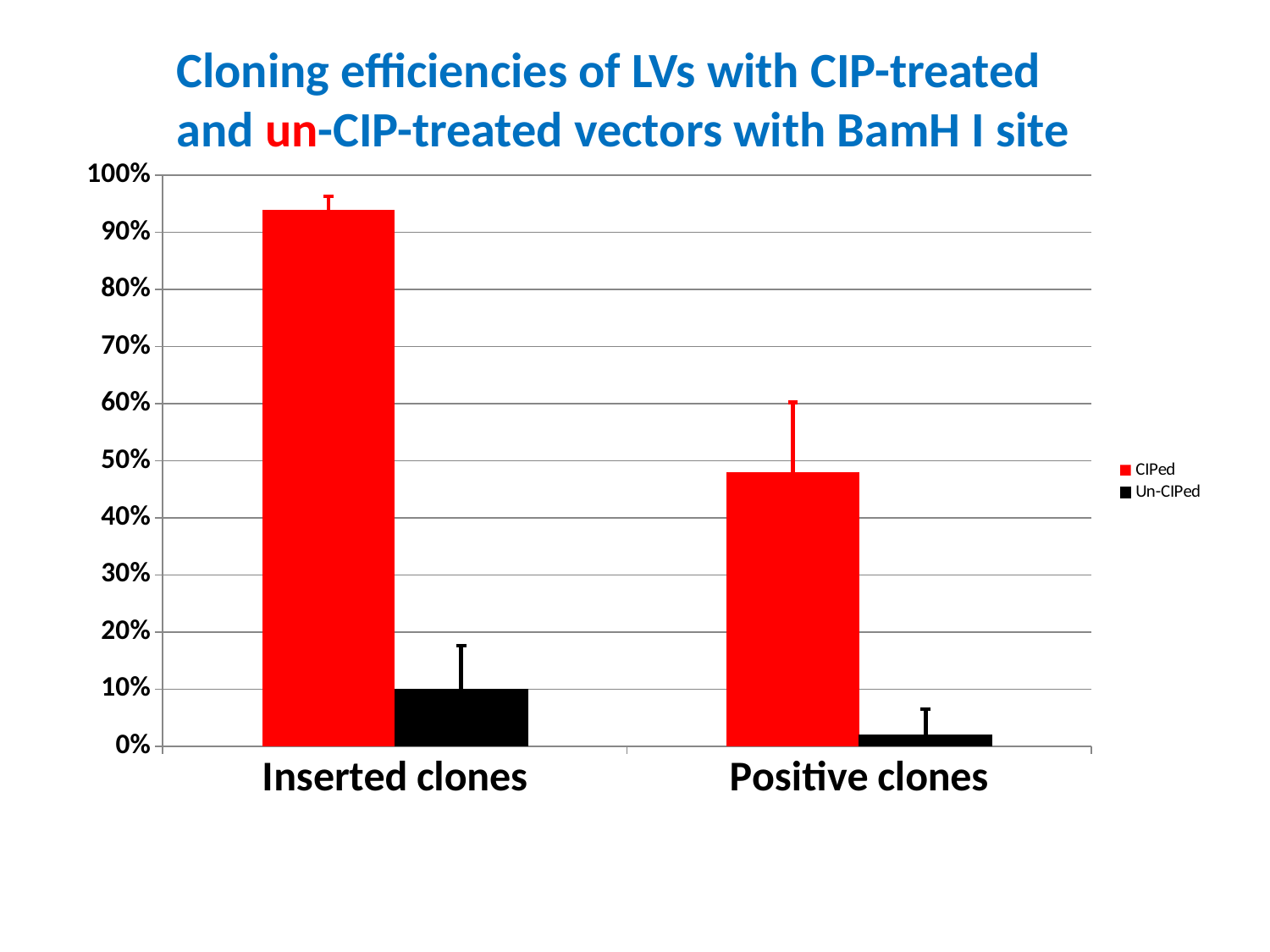
Which series is shown in red? CIPed What kind of chart is shown on the slide? bar chart Is the Un-CIPed value for Positive clones greater or less than 10%? less Do the CIPed values rise or fall from Inserted clones to Positive clones? fall Is the Un-CIPed value for Inserted clones greater or less than 20%? less Which category has the highest CIPed value? Inserted clones Which category has the lowest Un-CIPed value? Positive clones Is the CIPed value for Positive clones greater or less than 60%? less How many categories are shown on the x axis? 2 How many series does the legend list? 2 For Positive clones, which series has the larger value, CIPed or Un-CIPed? CIPed